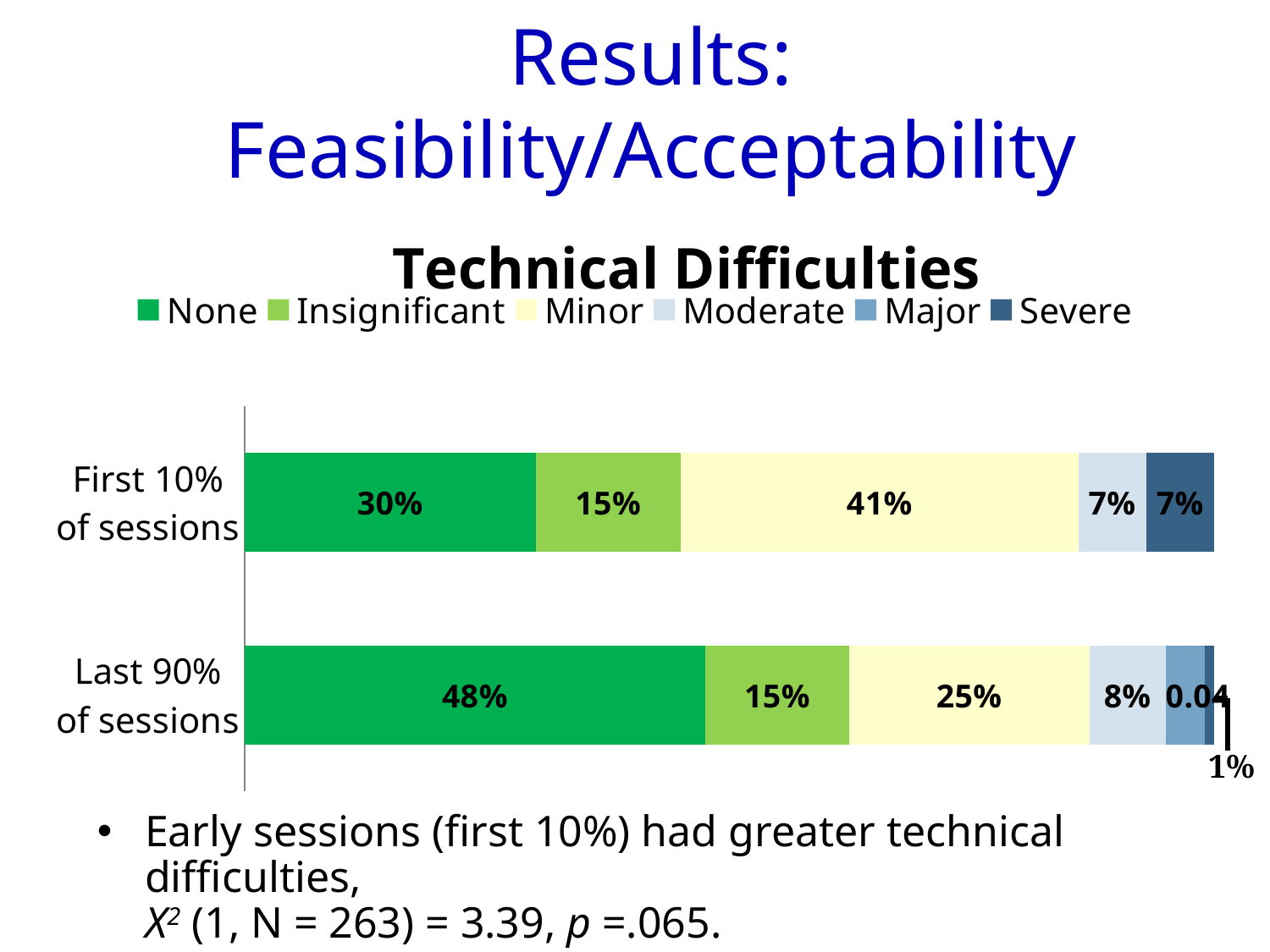
What percentage of the last 90% of sessions had no (None) technical difficulties? 48% How much larger is the Minor share for the first 10% of sessions than for the last 90% of sessions? 16% How many categories (bars) are shown in the chart? 2 What is the Moderate value for the last 90% of sessions? 8% How many series does the legend list? 6 What is the Minor value for the first 10% of sessions? 41% What kind of chart is shown on the slide? Stacked bar chart What percentage of the first 10% of sessions had no (None) technical difficulties? 30% How much larger is the None share for the last 90% of sessions than for the first 10% of sessions? 18% What is the Minor value for the last 90% of sessions? 25% Which group has the larger None share: the first 10% of sessions or the last 90% of sessions? Last 90% of sessions What is the Severe value for the first 10% of sessions? 7%